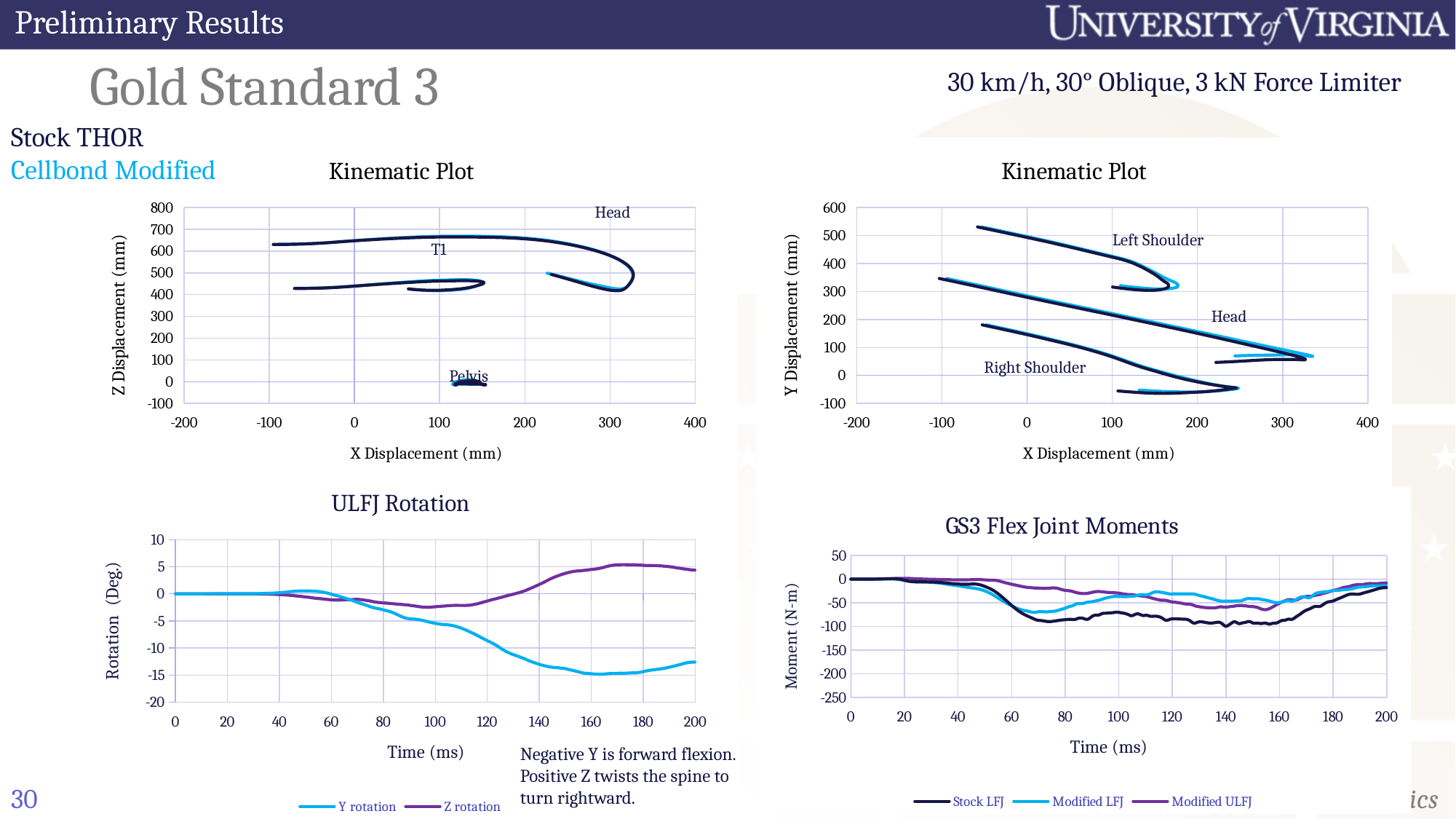
What is the y-axis label of the top-left Kinematic Plot? Z Displacement (mm) In the ULFJ Rotation chart, which series has the lower value at 160 ms, Y rotation or Z rotation? Y rotation What kind of chart is the GS3 Flex Joint Moments chart? line chart In the GS3 Flex Joint Moments chart, is the Stock LFJ value at 140 ms greater or less than -50? less In the ULFJ Rotation chart, how many series does the legend list? 2 In the ULFJ Rotation chart, does the Y rotation series rise or fall between 60 ms and 160 ms? fall What kind of chart is the ULFJ Rotation chart? line chart What is the x-axis label of the GS3 Flex Joint Moments chart? Time (ms) In the GS3 Flex Joint Moments chart, how many series does the legend list? 3 In the ULFJ Rotation chart, is the Z rotation value at 180 ms greater or less than 0? greater In the GS3 Flex Joint Moments chart, which series reaches the lowest moment value? Stock LFJ In the ULFJ Rotation chart, is the Y rotation value at 160 ms greater or less than -10? less